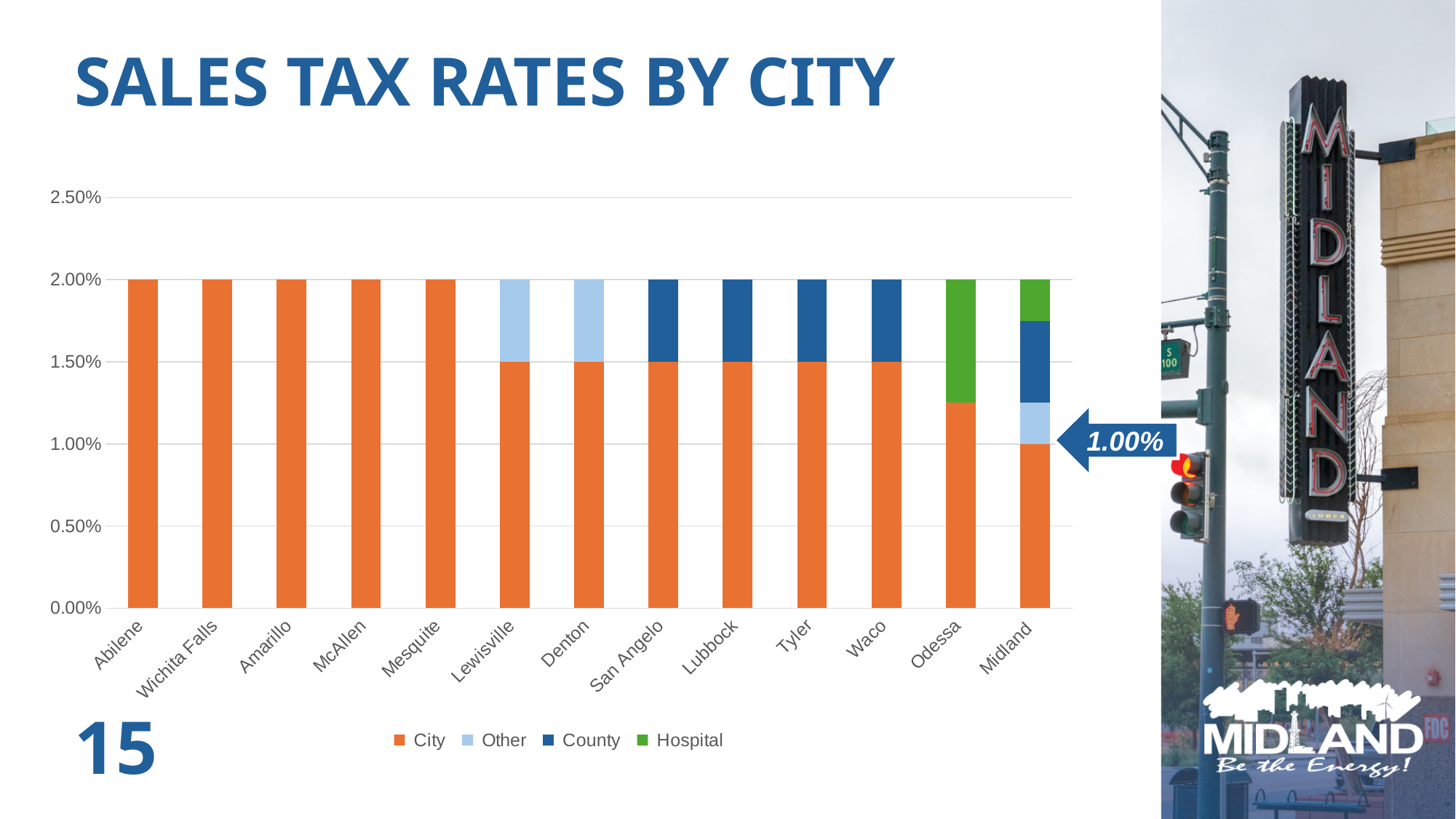
What is the City sales tax rate for Abilene? 2.00% What type of chart is shown on the slide? Stacked bar chart What is the City sales tax rate for Midland, as labeled by the arrow? 1.00% What is the total stacked sales tax rate for Midland? 2.00% How many series does the chart legend list? 4 What is the City sales tax rate for Lewisville? 1.50% What is the difference between the City sales tax rate for Abilene and the City sales tax rate for Midland? 1.00% Which has a larger City sales tax rate, Amarillo or Waco? Amarillo Which city has the lowest City sales tax rate? Midland Is the City sales tax rate for Odessa greater or less than 1.50%? less How many cities are shown on the x axis of the chart? 13 What is the title of the chart on the slide? SALES TAX RATES BY CITY